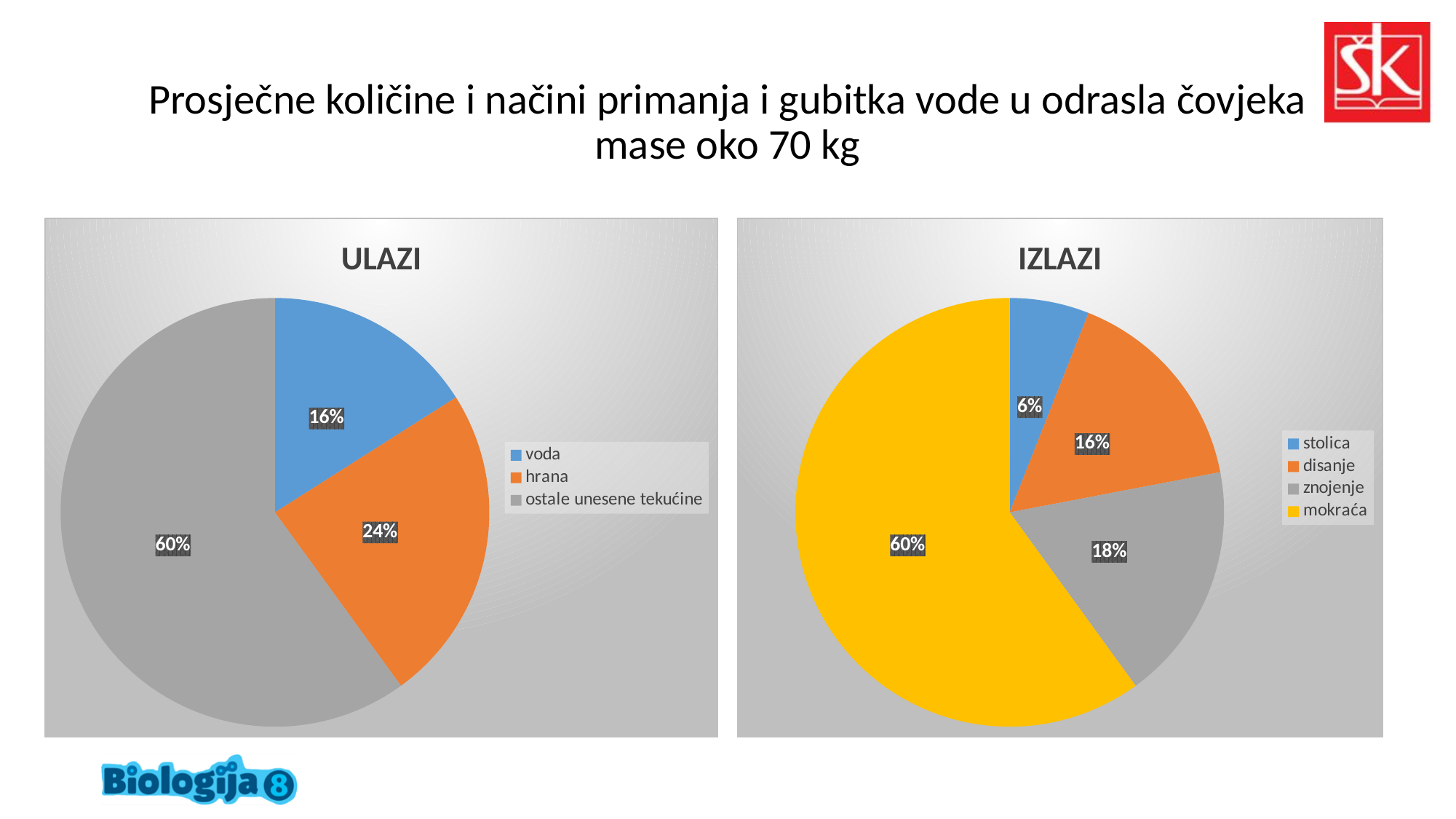
In the IZLAZI chart, which is larger, disanje or znojenje? znojenje What type of chart is the IZLAZI chart? pie chart In the IZLAZI chart, what share does znojenje have? 18% In the IZLAZI chart, what share does stolica have? 6% In the ULAZI chart, which category has the largest share? ostale unesene tekućine In the ULAZI chart, what share does voda have? 16% In the ULAZI chart, how many categories are shown? 3 In the IZLAZI chart, which category has the largest share? mokraća In the IZLAZI chart, how many categories does the legend list? 4 In the ULAZI chart, what share does hrana have? 24% In the ULAZI chart, which category has the smallest share? voda In the ULAZI chart, what is the difference between the shares of hrana and voda? 8%